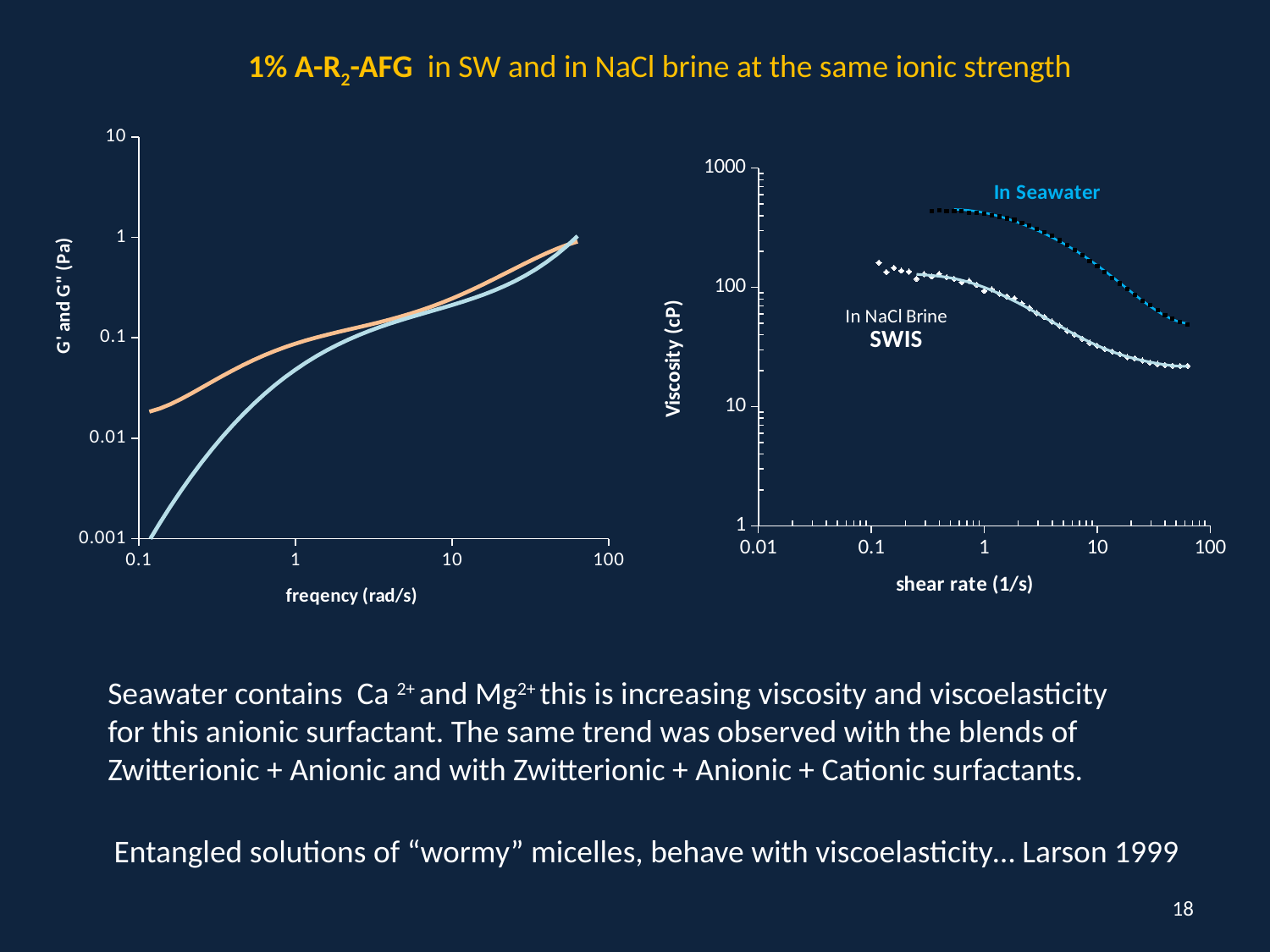
What kind of chart is the left chart showing G' and G'' against frequency? line chart What is the x-axis label of the right chart? shear rate (1/s) In the left chart, is the value of the light blue curve at a frequency of 0.1 rad/s greater or less than 0.01 Pa? less In the right chart, does viscosity rise or fall as shear rate increases? fall In the left chart, is the value of the orange curve at a frequency of 0.1 rad/s greater or less than 0.1 Pa? less In the right chart, is the viscosity of the In Seawater series at a shear rate of 1 1/s greater or less than 100 cP? greater In the right chart, which series has the higher viscosity across the shear rate range, In Seawater or In NaCl Brine? In Seawater What kind of chart is the right chart showing viscosity against shear rate? scatter chart What is the y-axis label of the left chart? G' and G" (Pa) In the left chart, do the G' and G'' values rise or fall as frequency increases? rise